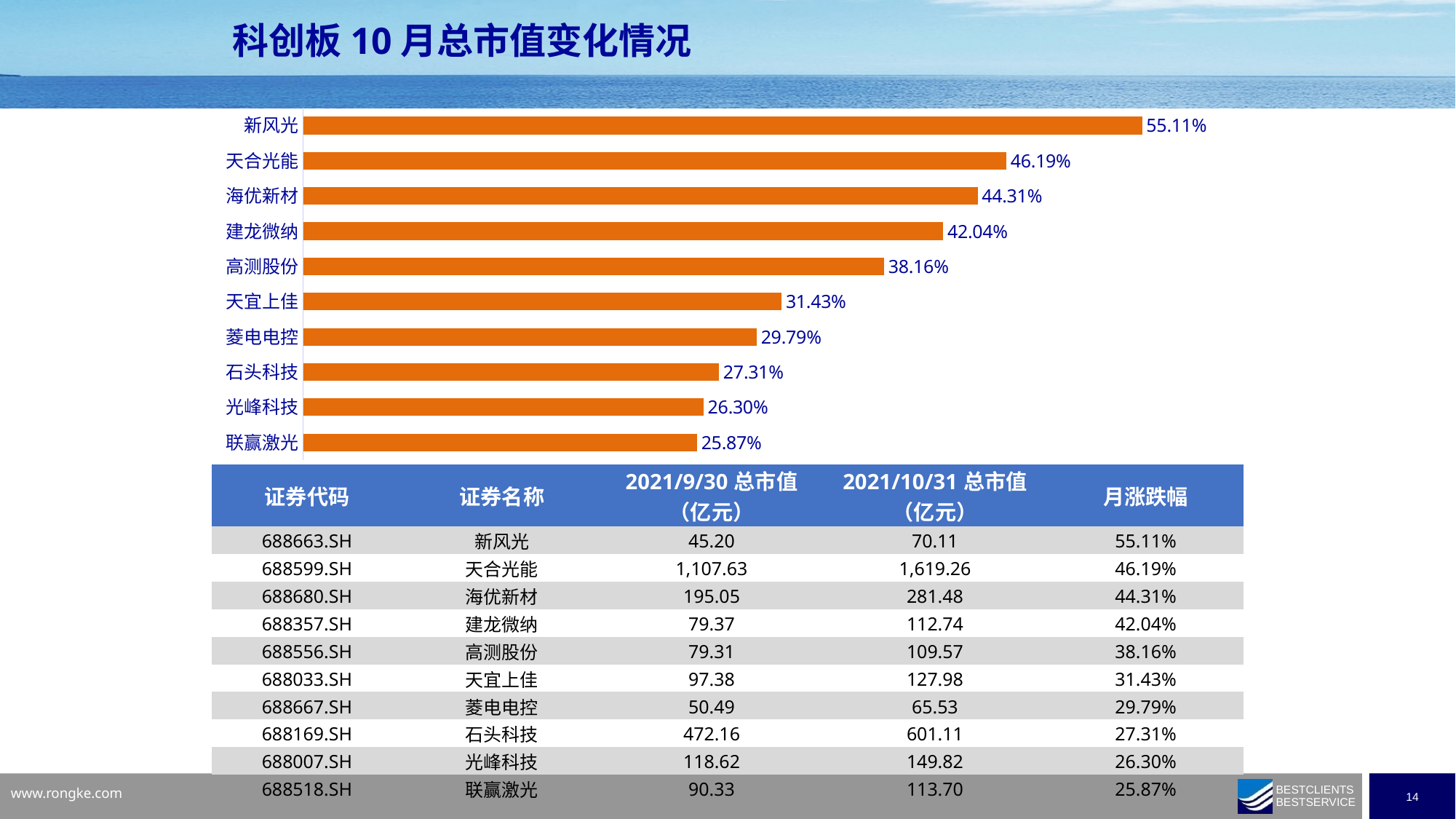
Which category has the highest value in the bar chart? 新风光 What is the value shown for 新风光 in the bar chart? 55.11% What is the difference between the values for 新风光 and 天合光能 in the bar chart? 8.92% What is the title of the slide containing the chart? 科创板 10 月总市值变化情况 What is the difference between the values for 天宜上佳 and 菱电电控 in the bar chart? 1.64% What is the value shown for 联赢激光 in the bar chart? 25.87% Which category has the lowest value in the bar chart? 联赢激光 How many categories are shown in the bar chart? 10 What is the value shown for 高测股份 in the bar chart? 38.16% What kind of chart is shown on the slide? Bar chart Which has a larger value in the bar chart, 石头科技 or 光峰科技? 石头科技 Which has a larger value in the bar chart, 海优新材 or 建龙微纳? 海优新材